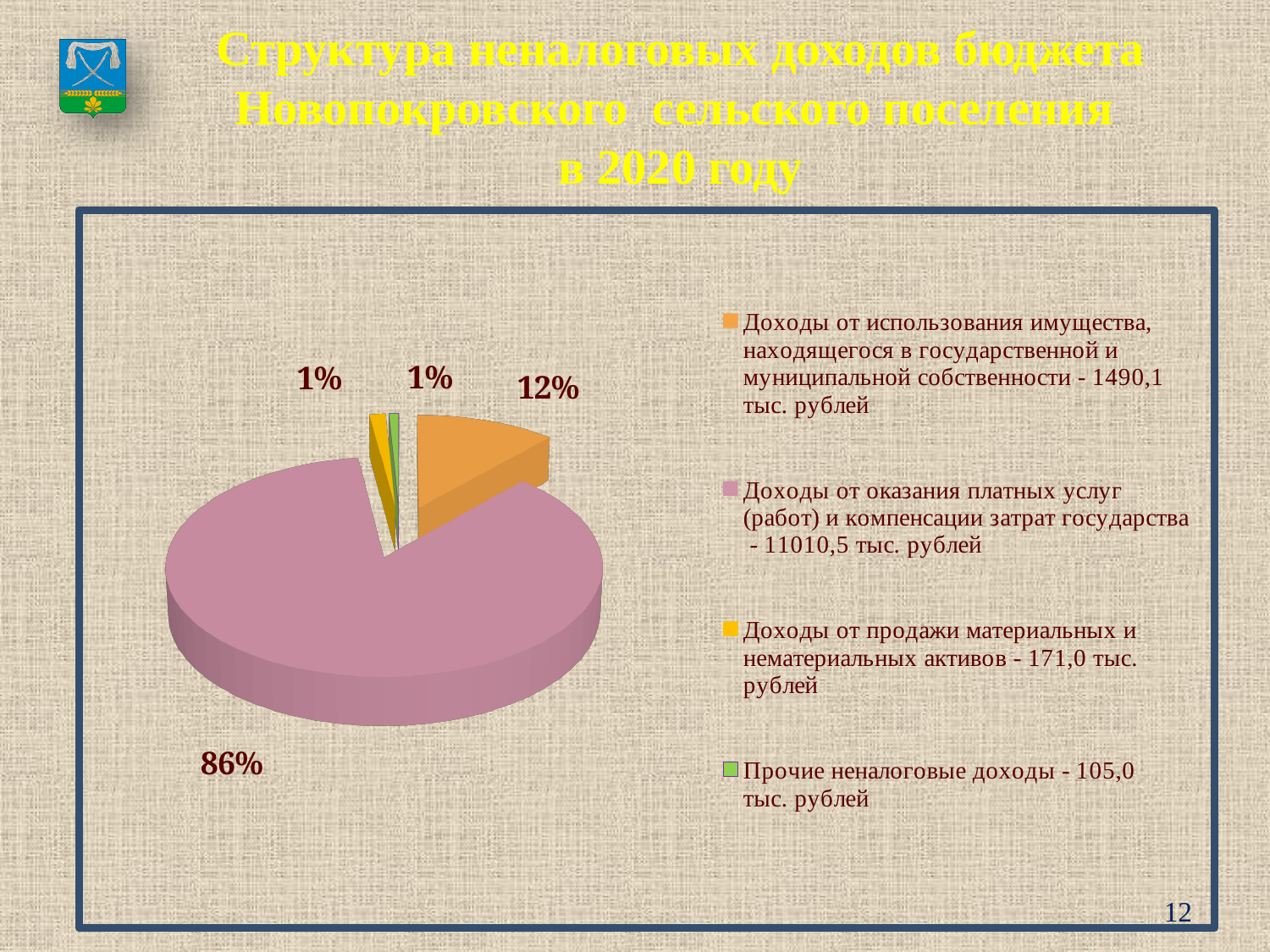
What colour is the largest slice of the pie? Pink What amount does the legend give for 'Доходы от продажи материальных и нематериальных активов'? 171,0 тыс. рублей What share of the pie does the largest slice represent? 86% What share of the pie is labelled for 'Доходы от использования имущества, находящегося в государственной и муниципальной собственности'? 12% What amount does the legend give for 'Прочие неналоговые доходы'? 105,0 тыс. рублей What is the difference between the amounts for 'Доходы от оказания платных услуг' (11010,5) and 'Доходы от использования имущества' (1490,1) in тыс. рублей? 9520,4 What is the difference in percentage points between the 86% slice and the 12% slice? 74 What kind of chart is shown on the slide? Pie chart Which category has the largest slice of the pie? Доходы от оказания платных услуг (работ) и компенсации затрат государства Which is larger: the share for 'Доходы от использования имущества' or the share for 'Доходы от продажи материальных и нематериальных активов'? Доходы от использования имущества How many slices does the pie chart have? 4 Which category has the smallest amount according to the legend? Прочие неналоговые доходы